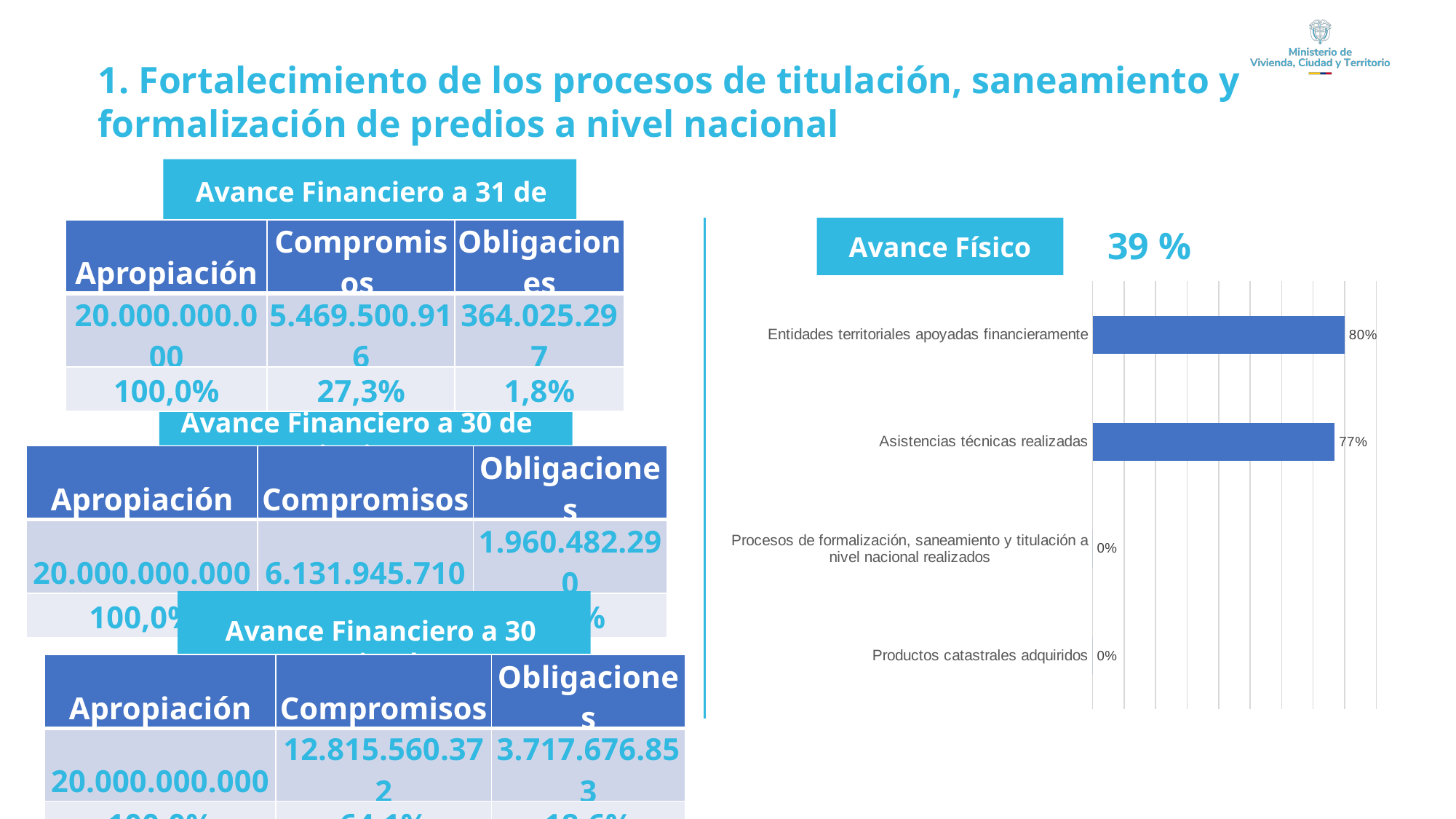
What is the difference between the values for Entidades territoriales apoyadas financieramente and Asistencias técnicas realizadas? 3% Which is larger: the value for Asistencias técnicas realizadas or the value for Productos catastrales adquiridos? Asistencias técnicas realizadas What is the value for Asistencias técnicas realizadas? 77% What is the value for Productos catastrales adquiridos? 0% How many categories in the chart have a value of 0%? 2 What overall percentage is displayed next to the Avance Físico title? 39 % What type of chart is shown on the slide? bar chart What is the title shown above the bar chart? Avance Físico What is the value for Entidades territoriales apoyadas financieramente? 80% What is the value for Procesos de formalización, saneamiento y titulación a nivel nacional realizados? 0% Which category has the highest value in the chart? Entidades territoriales apoyadas financieramente How many categories are shown in the bar chart? 4